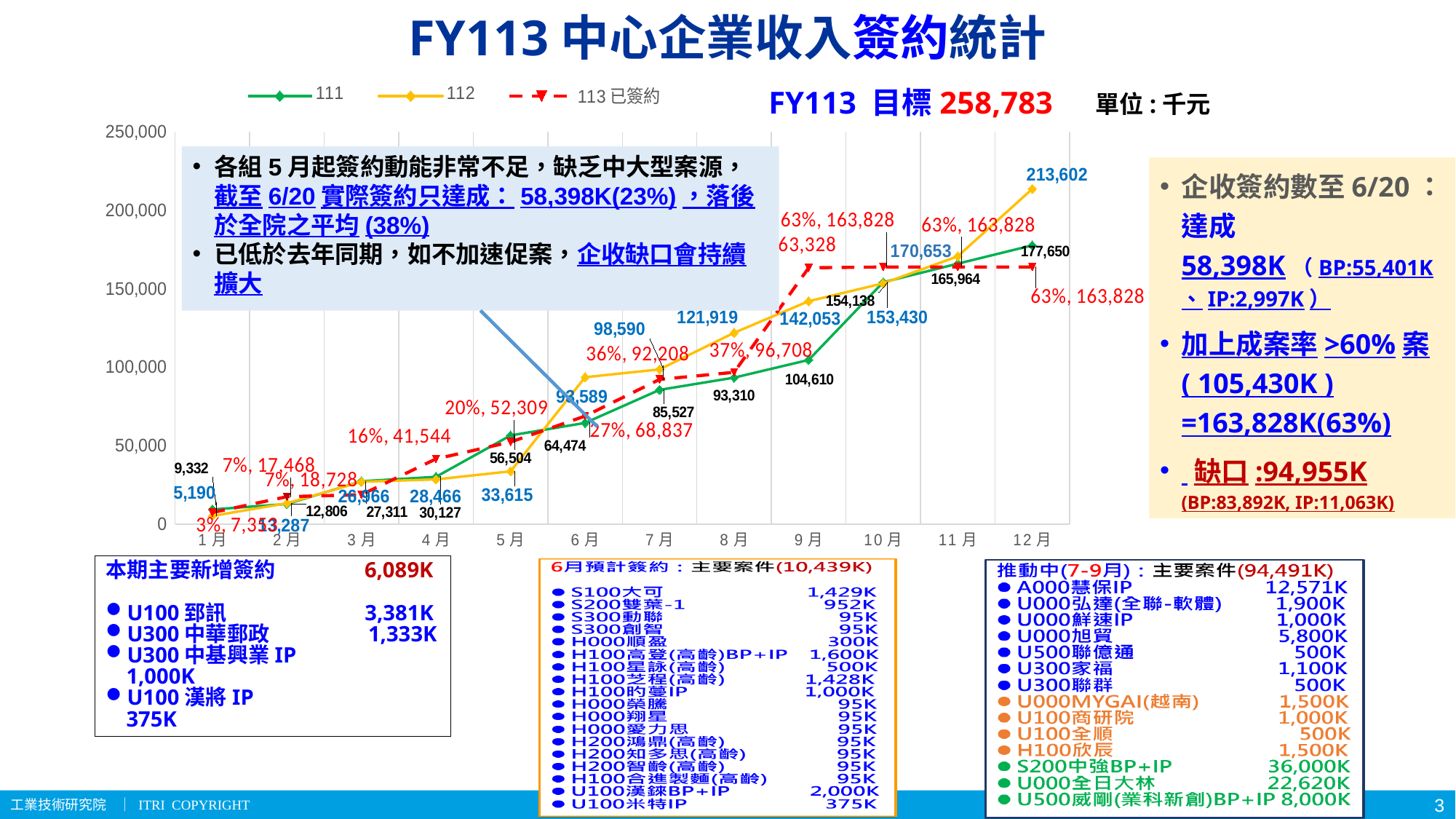
Do the values of the 112 series rise or fall from 1月 to 12月? rise What is the value of the 112 series at 6月? 93,589 What FY113 target value is stated above the chart? 258,783 At 12月, which series is larger, 111 or 112? 112 In which month does the 112 series reach its highest value? 12月 What is the value of the 111 series at 12月? 177,650 How many series does the chart legend list? 3 What is the difference between the 112 and 111 values at 12月? 35,952 What is the value of the 112 series at 12月? 213,602 What kind of chart is shown on the slide? line chart What is the value of the 111 series at 9月? 104,610 How many months are shown along the x axis of the chart? 12